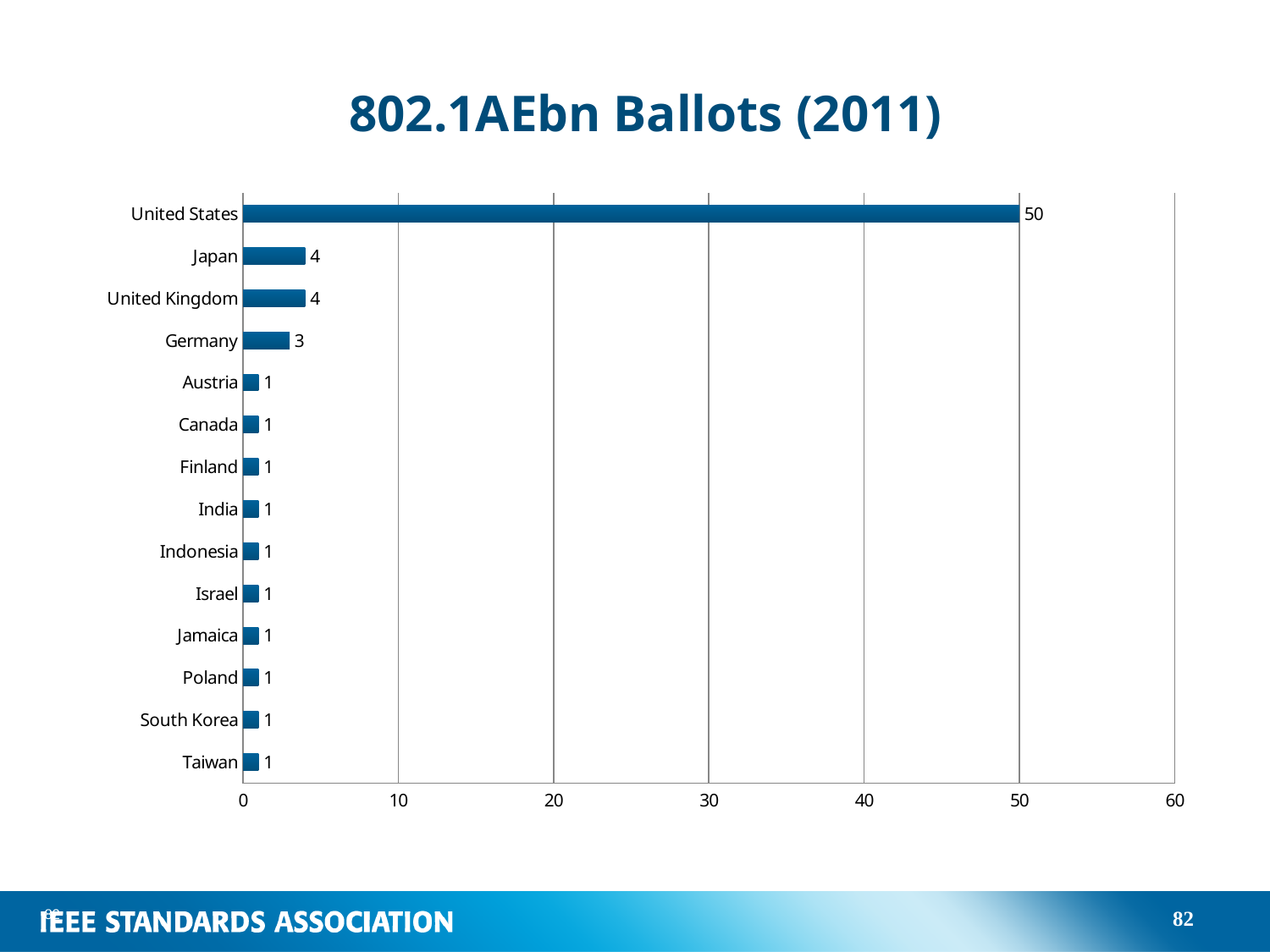
Which is larger, the value for Germany or the value for Austria? Germany What is the difference between the values for United States and Japan? 46 What is the difference between the values for United Kingdom and Germany? 1 Which category has the highest value? United States What is the value for Germany? 3 How many categories are shown in the chart? 14 How many categories have a value of 1? 10 What kind of chart is shown on the slide? bar chart What is the title of the chart? 802.1AEbn Ballots (2011) Is the value for United States greater or less than 40? greater What is the value for Japan? 4 What is the value for United States? 50